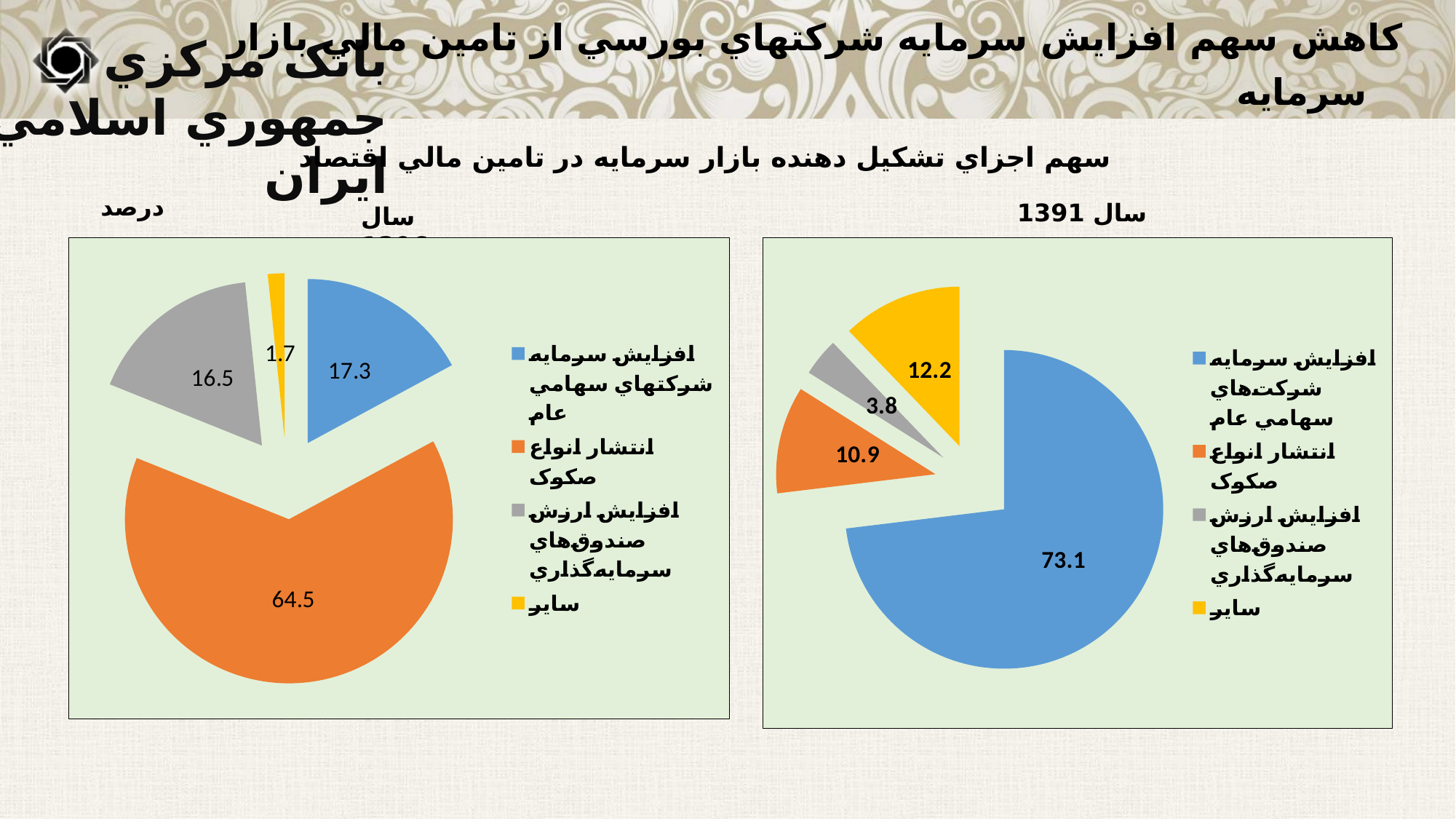
How many entries does the legend of the right pie chart (سال 1391) list? 4 In the left pie chart, what is the value for انتشار انواع صكوك? 64.5 In the left pie chart, which is larger: افزايش سرمايه شركتهاي سهامي عام or افزايش ارزش صندوق‌هاي سرمايه‌گذاري? افزايش سرمايه شركتهاي سهامي عام In the right pie chart (سال 1391), what is the value for انتشار انواع صكوك? 10.9 In the right pie chart (سال 1391), what is the value for ساير? 12.2 In the left pie chart, which category has the largest slice? انتشار انواع صكوك In the left pie chart, which category has the smallest slice? ساير In the right pie chart (سال 1391), which category has the smallest slice? افزايش ارزش صندوق‌هاي سرمايه‌گذاري In the right pie chart (سال 1391), what is the difference between the values for ساير and انتشار انواع صكوك? 1.3 In the right pie chart (سال 1391), what is the value for افزايش سرمايه شركت‌هاي سهامي عام? 73.1 In the left pie chart, what is the value for افزايش ارزش صندوق‌هاي سرمايه‌گذاري? 16.5 What type of chart is shown on the left side of the slide? Pie chart